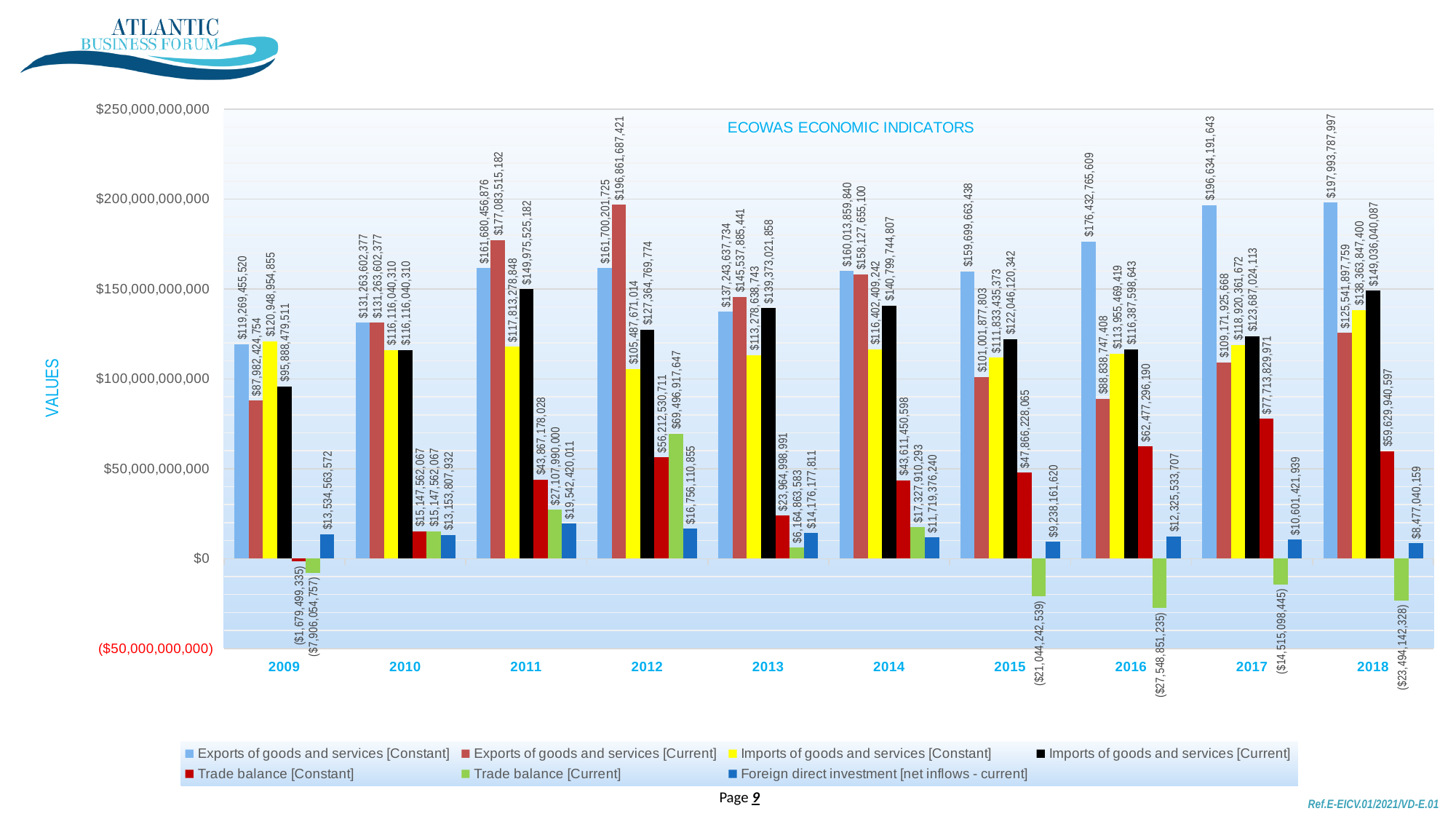
Which is larger in 2011: Exports of goods and services [Current] or Imports of goods and services [Current]? Exports of goods and services [Current] Is the value for Exports of goods and services [Constant] in 2016 greater or less than $150,000,000,000? greater What is the difference between Trade balance [Current] and Trade balance [Constant] in 2012? $13,284,386,936 How many series does the legend list? 7 What is the value of Trade balance [Current] in 2016? ($27,548,851,235) In which year is Foreign direct investment [net inflows - current] lowest? 2018 In which year is Exports of goods and services [Constant] highest? 2018 How many years are shown on the x axis? 10 What is the value of Foreign direct investment [net inflows - current] in 2009? $13,534,563,572 What is the value of Exports of goods and services [Current] in 2012? $196,861,687,421 What kind of chart is shown on the slide? Bar chart What is the difference between Exports of goods and services [Constant] and Exports of goods and services [Current] in 2018? $72,451,890,238